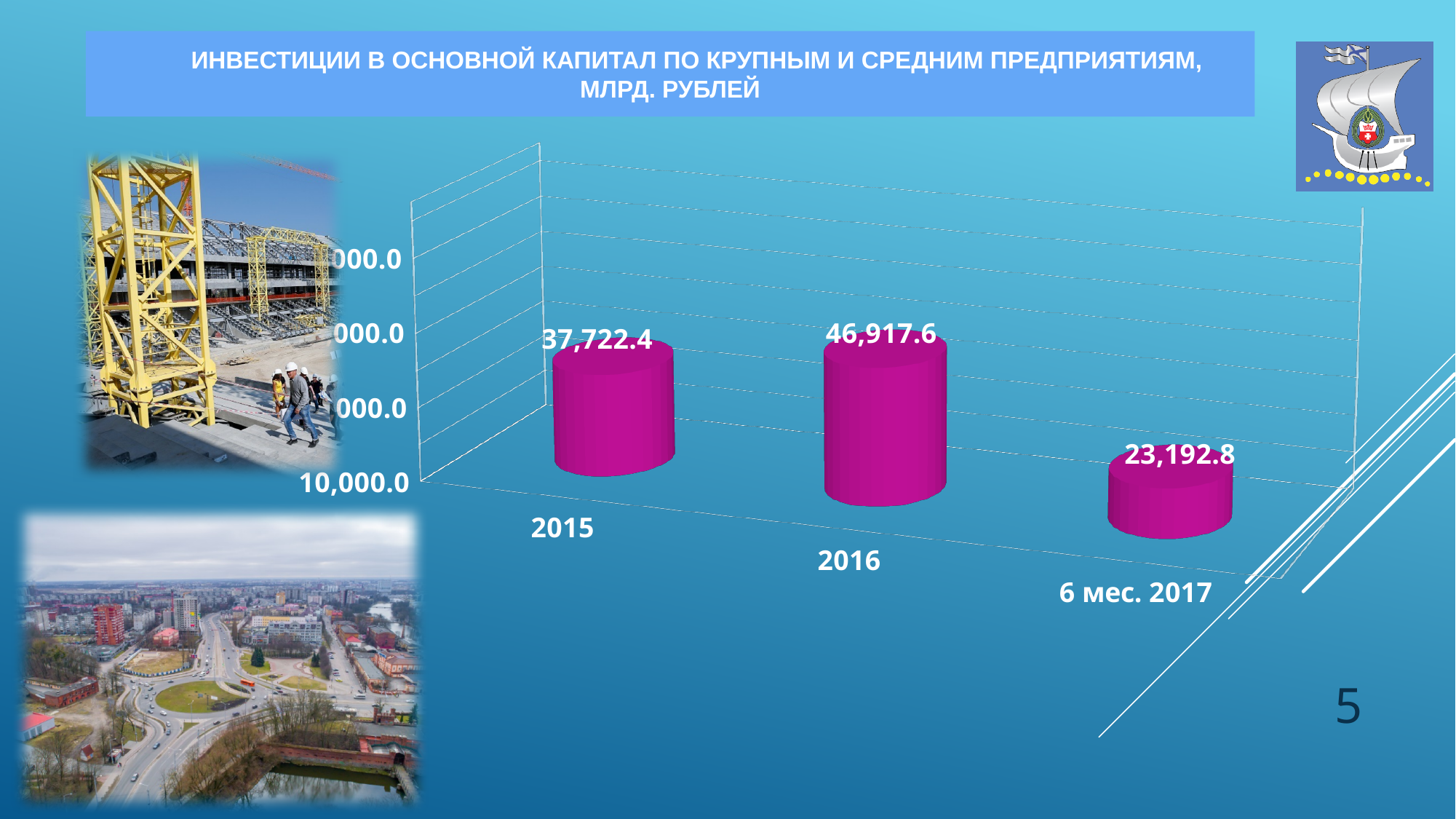
What unit is stated in the chart title? МЛРД. РУБЛЕЙ Which category has the lowest value? 6 мес. 2017 Which is larger, the value for 2015 or the value for 6 мес. 2017? 2015 What is the difference between the values for 2016 and 2015? 9,195.2 What is the value for 2016? 46,917.6 What kind of chart is shown on the slide? Bar chart Which category has the highest value? 2016 What is the value for 6 мес. 2017? 23,192.8 What is the value for 2015? 37,722.4 What is the difference between the values for 2015 and 6 мес. 2017? 14,529.6 Does the value rise or fall from 2015 to 2016? Rise How many categories are shown on the x axis? 3